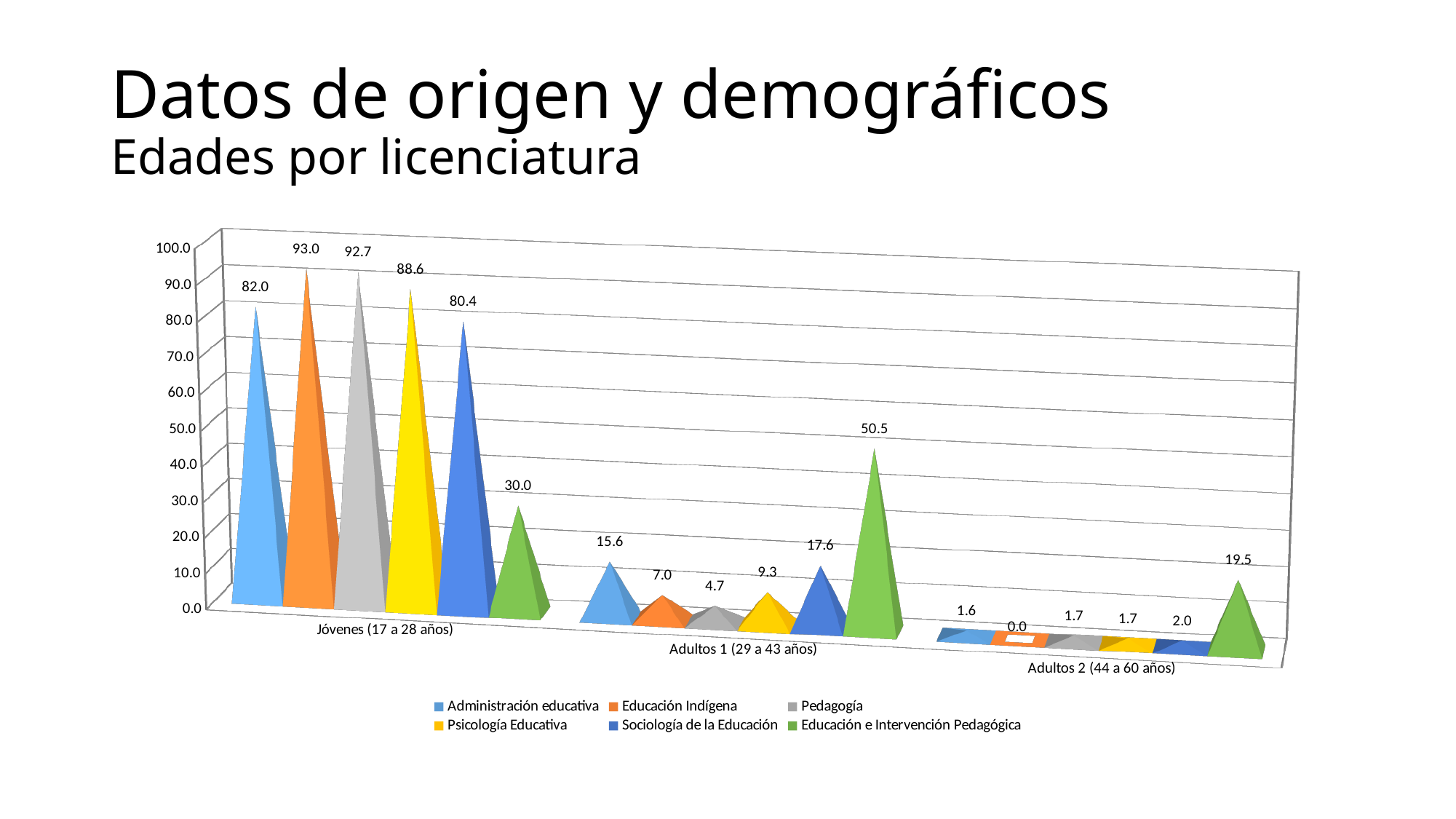
What is the value for Educación e Intervención Pedagógica in the Adultos 1 (29 a 43 años) category? 50.5 What is the value for Sociología de la Educación in the Adultos 2 (44 a 60 años) category? 2.0 What is the subtitle of the slide below the main title? Edades por licenciatura How many age categories are shown on the x axis? 3 What kind of chart is shown on the slide? Bar chart Which series has the lowest value in the Adultos 2 (44 a 60 años) category? Educación Indígena What is the value for Educación Indígena in the Jóvenes (17 a 28 años) category? 93.0 In the Adultos 1 (29 a 43 años) category, which is larger: Administración educativa or Sociología de la Educación? Sociología de la Educación What is the difference between the Pedagogía value and the Administración educativa value in the Jóvenes (17 a 28 años) category? 10.7 How many series does the legend list? 6 Which series has the highest value in the Jóvenes (17 a 28 años) category? Educación Indígena